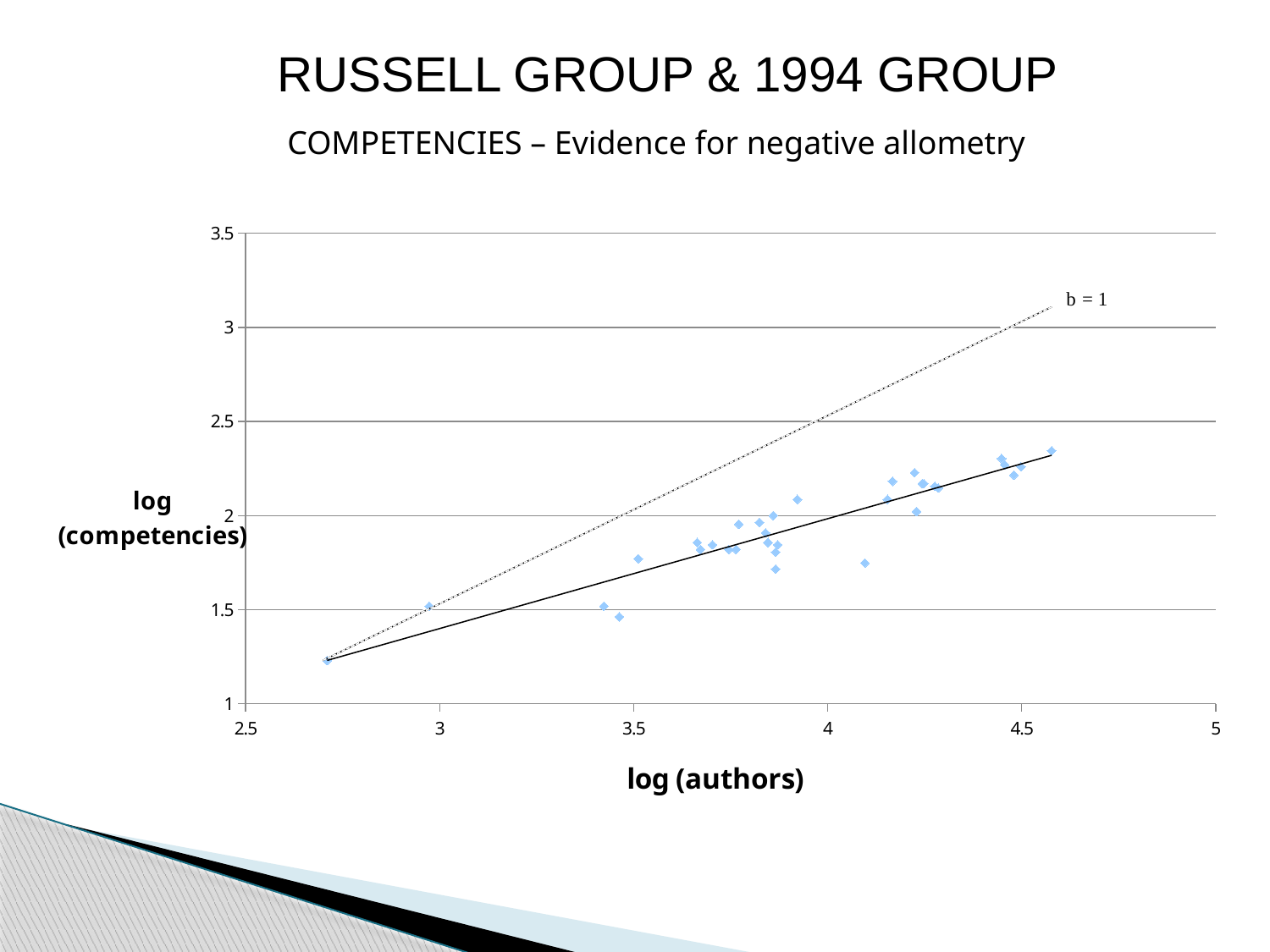
Is the log (competencies) value of the rightmost data point (near log (authors) = 4.6) greater or less than 2.5? less Which has the higher log (competencies) value: the leftmost data point or the rightmost data point? the rightmost data point Is the log (competencies) value of the data point near log (authors) = 4.1 greater or less than 2? less What is the title of the x axis? log (authors) Is the log (competencies) value of the data point near log (authors) = 3.0 greater or less than 2? less Do the plotted log (competencies) values generally rise or fall as log (authors) increases? rise What label is printed next to the dotted reference line? b = 1 What kind of chart is shown on the slide? scatter chart